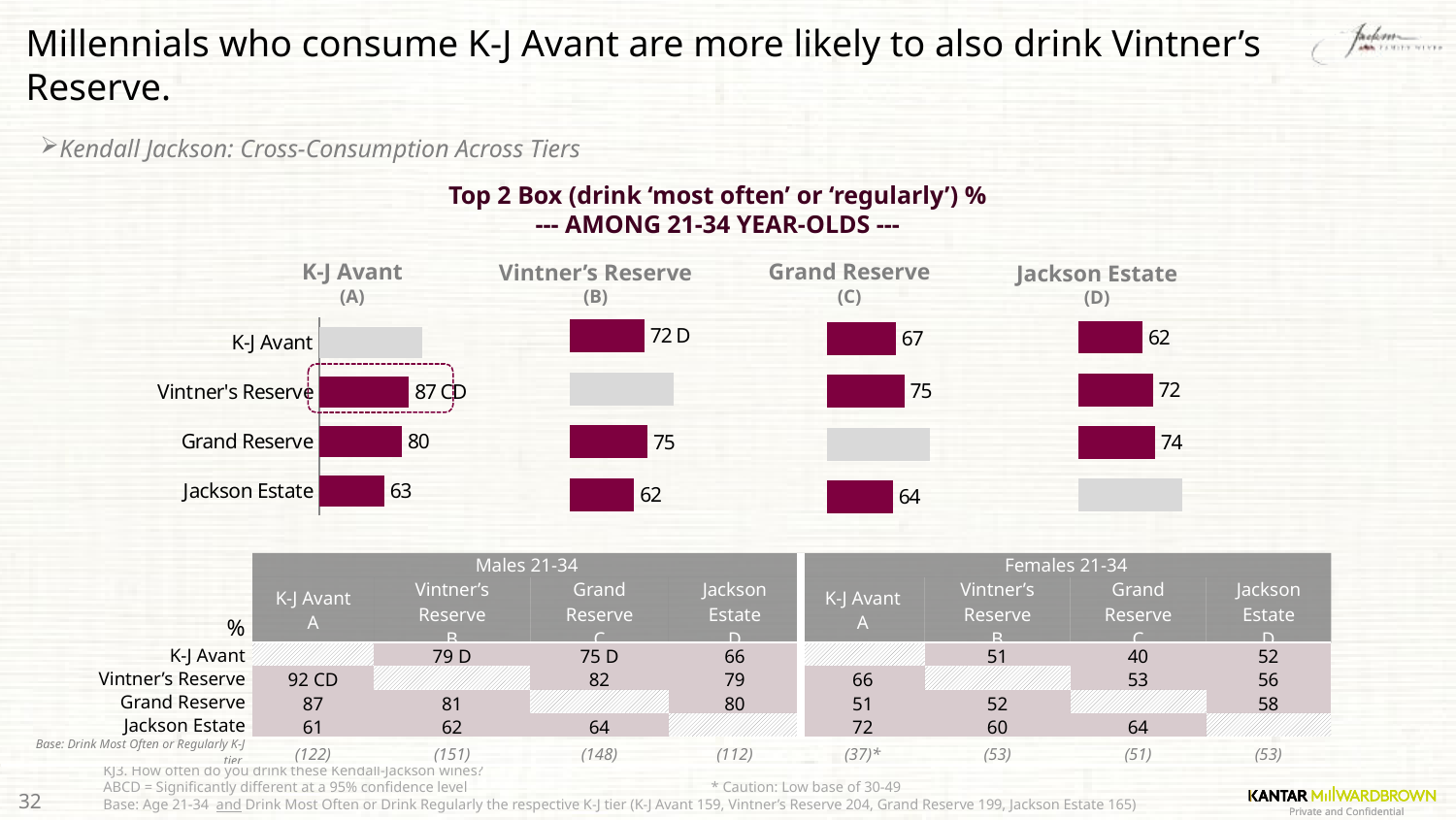
In the Vintner's Reserve chart, what is the value for K-J Avant? 72 In the Grand Reserve chart, what is the value for Jackson Estate? 64 In the K-J Avant chart, what is the value for Grand Reserve? 80 In the Vintner's Reserve chart, what is the difference between the values for Grand Reserve and Jackson Estate? 13 What type of chart is used for the K-J Avant chart? Bar chart How many bar charts are shown on the slide? 4 In the K-J Avant chart, what is the difference between the values for Vintner's Reserve and Jackson Estate? 24 In the Jackson Estate chart, which is larger: the value for K-J Avant or the value for Vintner's Reserve? Vintner's Reserve In the Jackson Estate chart, what is the value for Grand Reserve? 74 In the K-J Avant chart, which labelled category has the lowest value? Jackson Estate In the Grand Reserve chart, which labelled category has the highest value? Vintner's Reserve In the K-J Avant chart, what is the value for Vintner's Reserve? 87